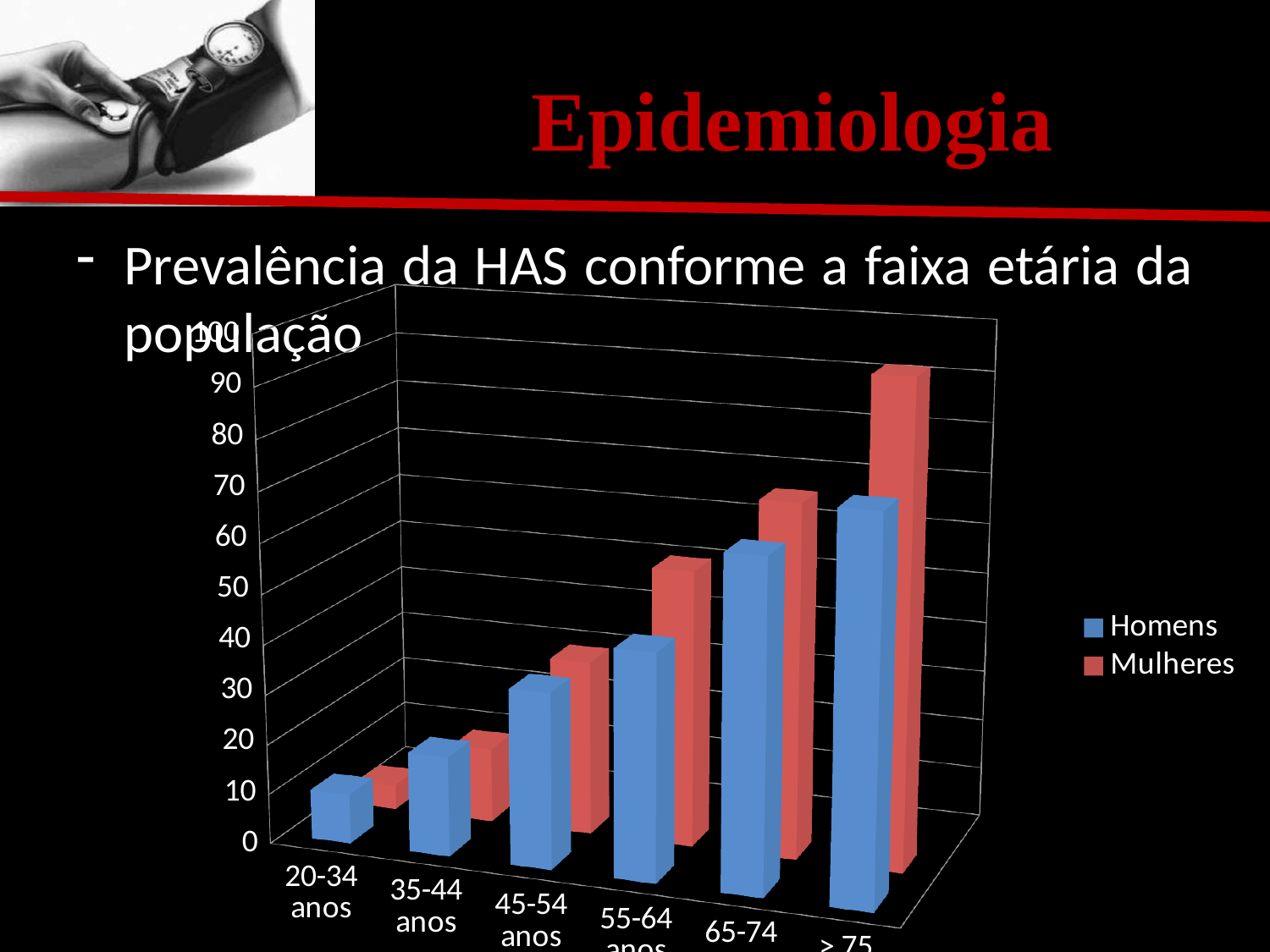
What kind of chart is shown on the slide? bar chart Which series is shown in red in the legend? Mulheres In the > 75 age group, which series has the larger value, Homens or Mulheres? Mulheres Do the Homens values rise or fall as the age groups increase along the x axis? rise How many age-group categories are shown on the x axis? 6 How many series does the legend list? 2 For which age group is the Mulheres value highest? > 75 Is the Homens value for 20-34 anos greater or less than 20? less For which age group is the Homens value highest? > 75 Which series is shown in blue in the legend? Homens For which age group is the Homens value lowest? 20-34 anos Is the Mulheres value for > 75 greater or less than 80? greater